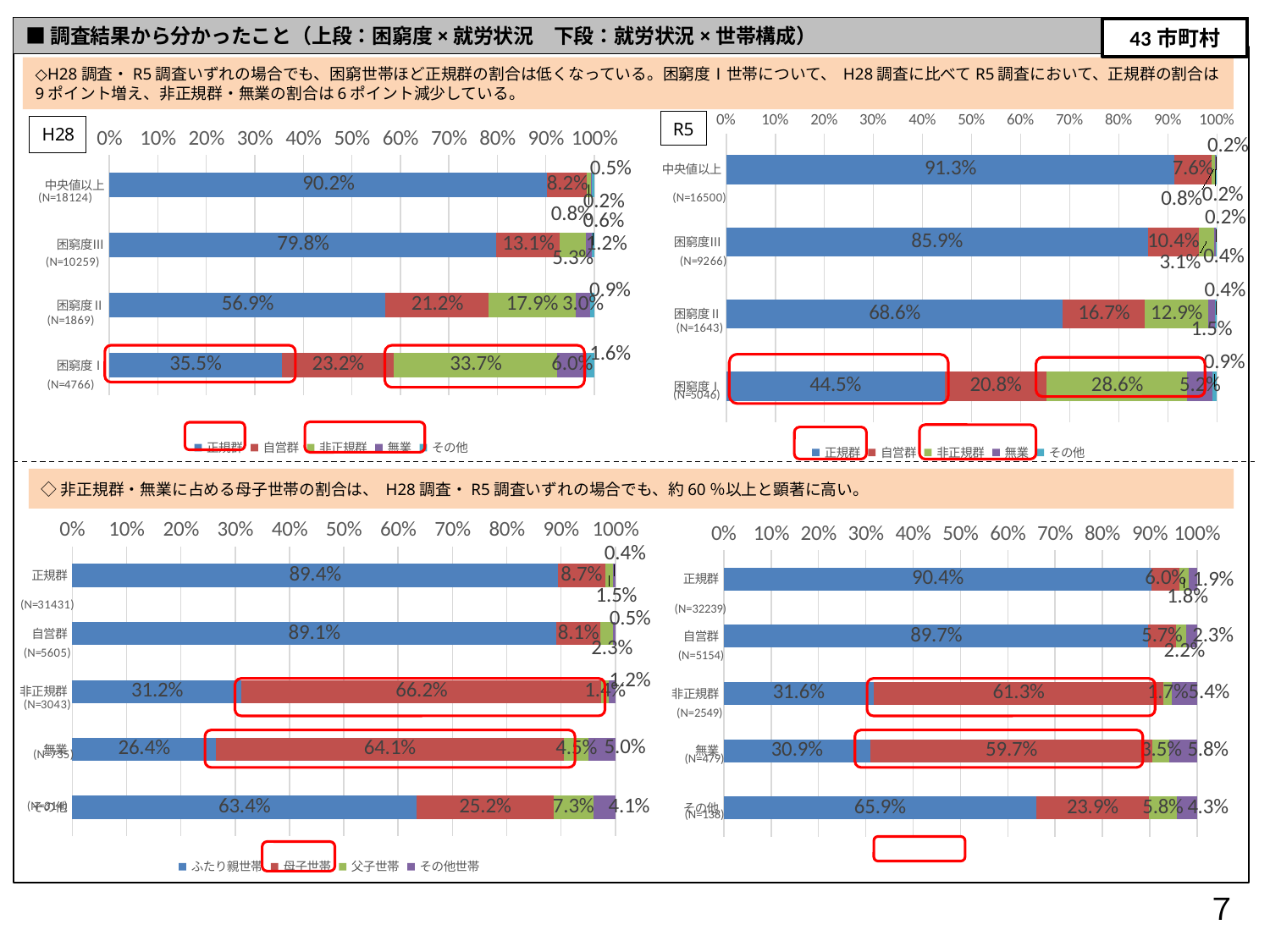
In the top-right R5 chart, what is the 非正規群 value for 困窮度Ⅰ? 28.6% In the top-left H28 chart, which category has the highest 正規群 value? 中央値以上 In the top-left H28 chart, what is the 正規群 value for 困窮度Ⅰ? 35.5% What kind of chart is the bottom-left chart? Stacked bar chart In the bottom-right chart, which is larger, the 母子世帯 value for 非正規群 or for 無業? 非正規群 How many series does the legend of the top-left H28 chart list? 5 In the bottom-left chart, what is the 母子世帯 value for 非正規群? 66.2% What is the difference between the 正規群 value for 困窮度Ⅰ in the top-right R5 chart (44.5%) and in the top-left H28 chart (35.5%)? 9 points In the top-right R5 chart, what is the 正規群 value for 困窮度Ⅰ? 44.5% How many series does the legend of the bottom-left chart list? 4 In the top-right R5 chart, which category has the lowest 正規群 value? 困窮度Ⅰ In the bottom-right chart, what is the 母子世帯 value for 無業? 59.7%